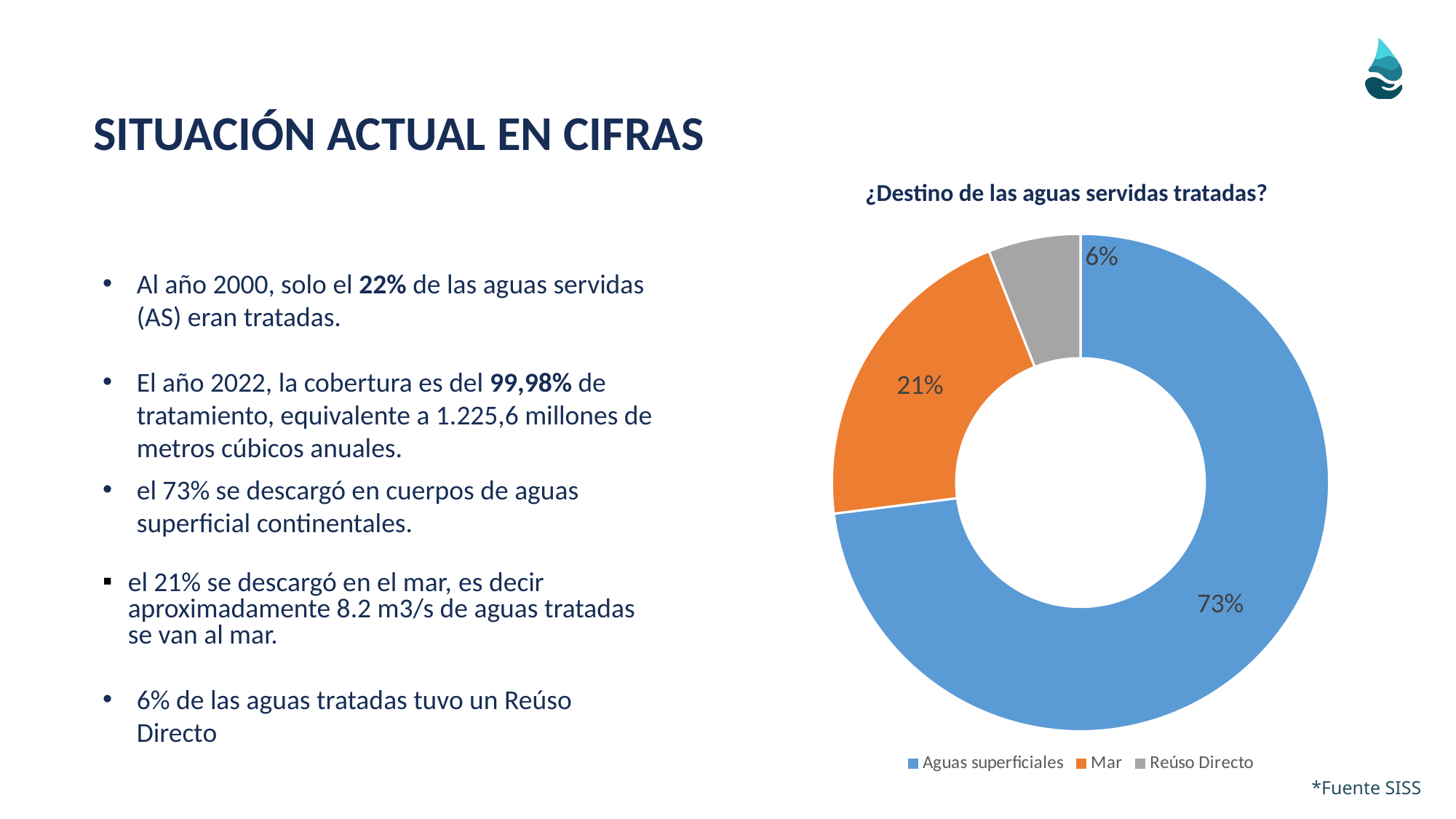
What is the difference in percentage points between Aguas superficiales and Mar? 52 What colour is the Mar slice in the pie chart? Orange What share of the pie does Aguas superficiales represent? 73% What is the title of the chart? ¿Destino de las aguas servidas tratadas? What share of the pie does Mar represent? 21% How many categories are shown in the pie chart? 3 Which category has the smallest share of the pie? Reúso Directo What kind of chart is shown on the slide? Doughnut chart Which category has the largest share of the pie? Aguas superficiales What share of the pie does Reúso Directo represent? 6% What is the difference in percentage points between Mar and Reúso Directo? 15 Which is larger, the share for Mar or the share for Reúso Directo? Mar